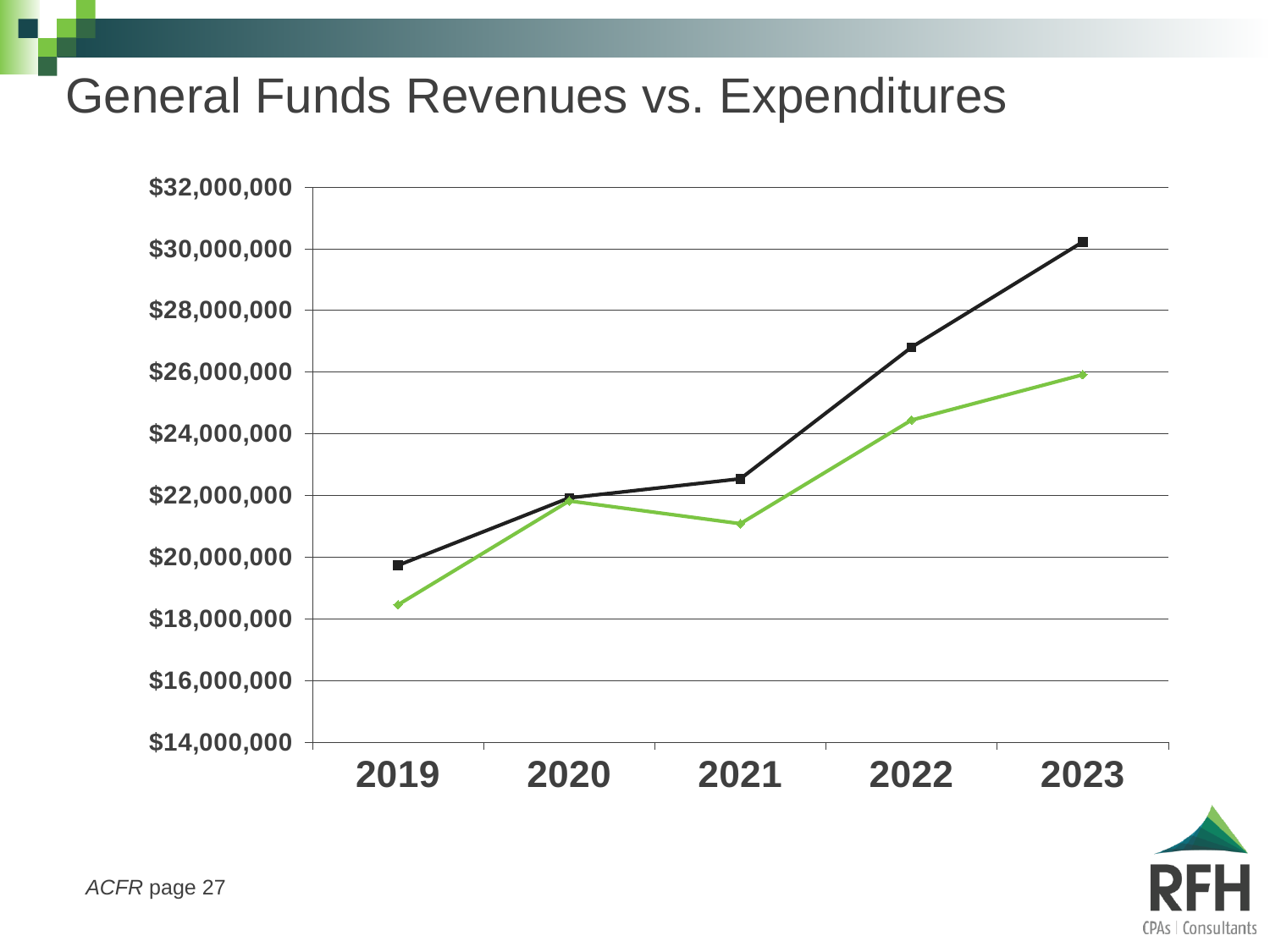
How many lines are plotted on the chart? 2 Is the value of the black line in 2023 greater or less than $28,000,000? greater In 2023, which line has the higher value, the black line or the green line? the black line What kind of chart is shown on the slide? line chart Is the value of the green line in 2019 greater or less than $20,000,000? less What is the title of the chart on the slide? General Funds Revenues vs. Expenditures Does the green line rise or fall from 2020 to 2021? fall In which year does the black line reach its highest value? 2023 Is the value of the green line in 2023 greater or less than $24,000,000? greater In which year is the green line at its lowest value? 2019 How many years are plotted along the x axis? 5